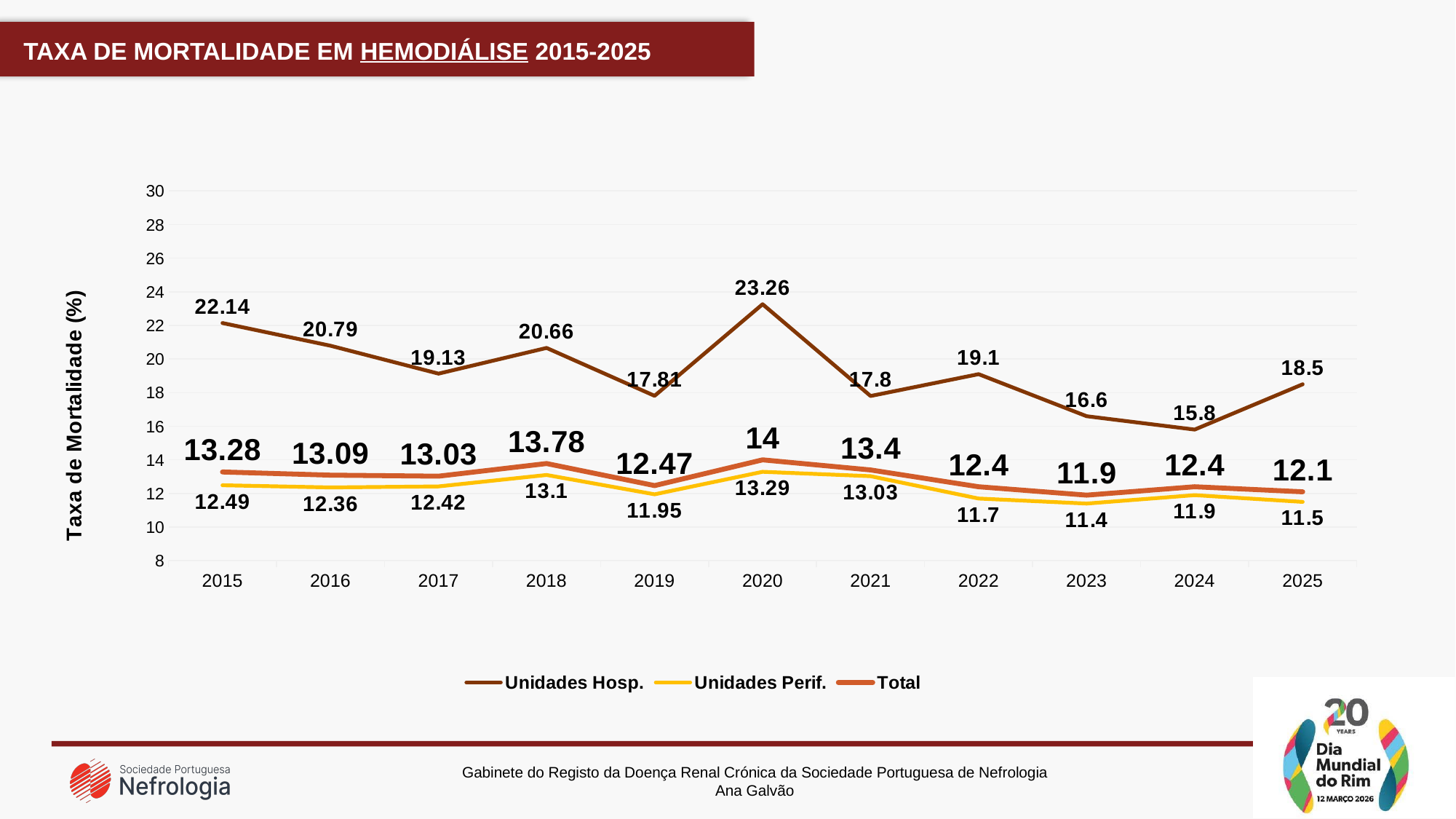
In which year is the Unidades Perif. value lowest? 2023 In which year is the Unidades Hosp. value lowest? 2024 In which year is the Unidades Hosp. value highest? 2020 What is the difference between the Unidades Hosp. value and the Unidades Perif. value in 2025? 7 What is the label of the y axis? Taxa de Mortalidade (%) What is the Total value in 2018? 13.78 How many series does the legend list? 3 What kind of chart is shown on the slide? line chart What is the value for Unidades Perif. in 2019? 11.95 What is the value for Unidades Hosp. in 2020? 23.26 Which is larger in 2021, the Unidades Hosp. value or the Total value? Unidades Hosp. How many years are plotted along the x axis? 11